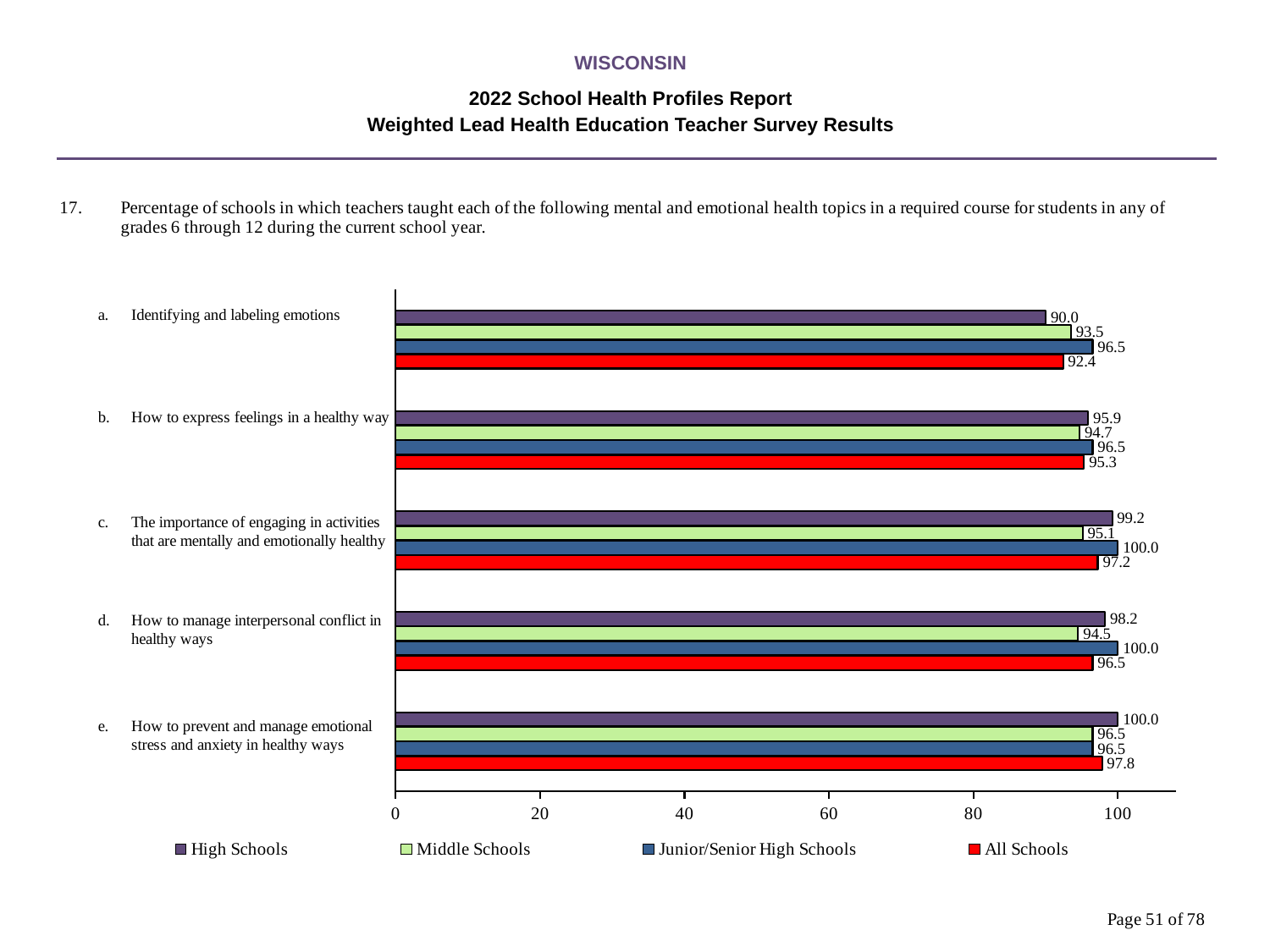
What is the difference between the Junior/Senior High Schools and High Schools values for 'Identifying and labeling emotions'? 6.5 What is the value for Middle Schools for 'How to manage interpersonal conflict in healthy ways'? 94.5 Which topic has the lowest value for High Schools? Identifying and labeling emotions What is the value for High Schools for 'Identifying and labeling emotions'? 90.0 What is the value for All Schools for 'How to prevent and manage emotional stress and anxiety in healthy ways'? 97.8 What is the value for Junior/Senior High Schools for 'How to express feelings in a healthy way'? 96.5 Which colour represents All Schools in the chart? Red How many topics (categories) are shown in the chart? 5 What kind of chart is shown on the slide? Bar chart How many series does the legend list? 4 Which topic has the highest value for All Schools? How to prevent and manage emotional stress and anxiety in healthy ways For 'The importance of engaging in activities that are mentally and emotionally healthy', which is larger: the High Schools value or the Middle Schools value? High Schools